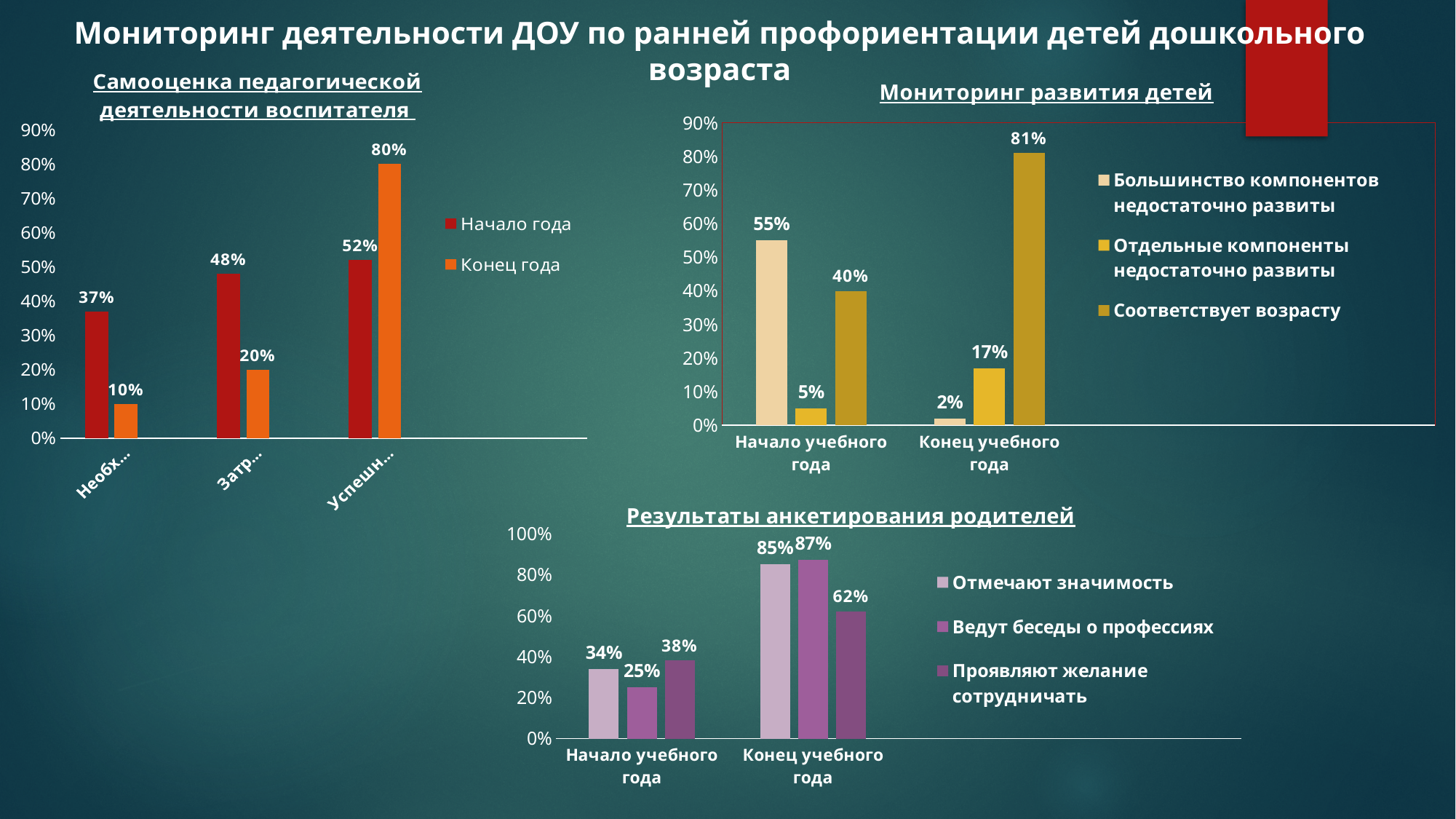
In the chart 'Результаты анкетирования родителей', what is the value for 'Ведут беседы о профессиях' at 'Конец учебного года'? 87% In the chart 'Мониторинг развития детей', what is the difference between the 'Соответствует возрасту' values at 'Конец учебного года' and 'Начало учебного года'? 41% In the chart 'Мониторинг развития детей', which series has the lowest value at 'Конец учебного года'? Большинство компонентов недостаточно развиты In the chart 'Результаты анкетирования родителей', is the value for 'Отмечают значимость' at 'Конец учебного года' larger or smaller than the value for 'Проявляют желание сотрудничать' at 'Конец учебного года'? larger How many series does the legend of the chart 'Мониторинг развития детей' list? 3 In the chart 'Мониторинг развития детей', what is the value for 'Соответствует возрасту' at 'Конец учебного года'? 81% In the chart 'Результаты анкетирования родителей', which series has the highest value at 'Начало учебного года'? Проявляют желание сотрудничать In the chart 'Мониторинг развития детей', what is the value for 'Большинство компонентов недостаточно развиты' at 'Начало учебного года'? 55% What kind of chart is 'Самооценка педагогической деятельности воспитателя'? bar chart How many series does the legend of the chart 'Самооценка педагогической деятельности воспитателя' list? 2 In the chart 'Результаты анкетирования родителей', what is the value for 'Проявляют желание сотрудничать' at 'Начало учебного года'? 38% In the chart 'Результаты анкетирования родителей', what is the difference between the 'Отмечают значимость' values at 'Конец учебного года' and 'Начало учебного года'? 51%